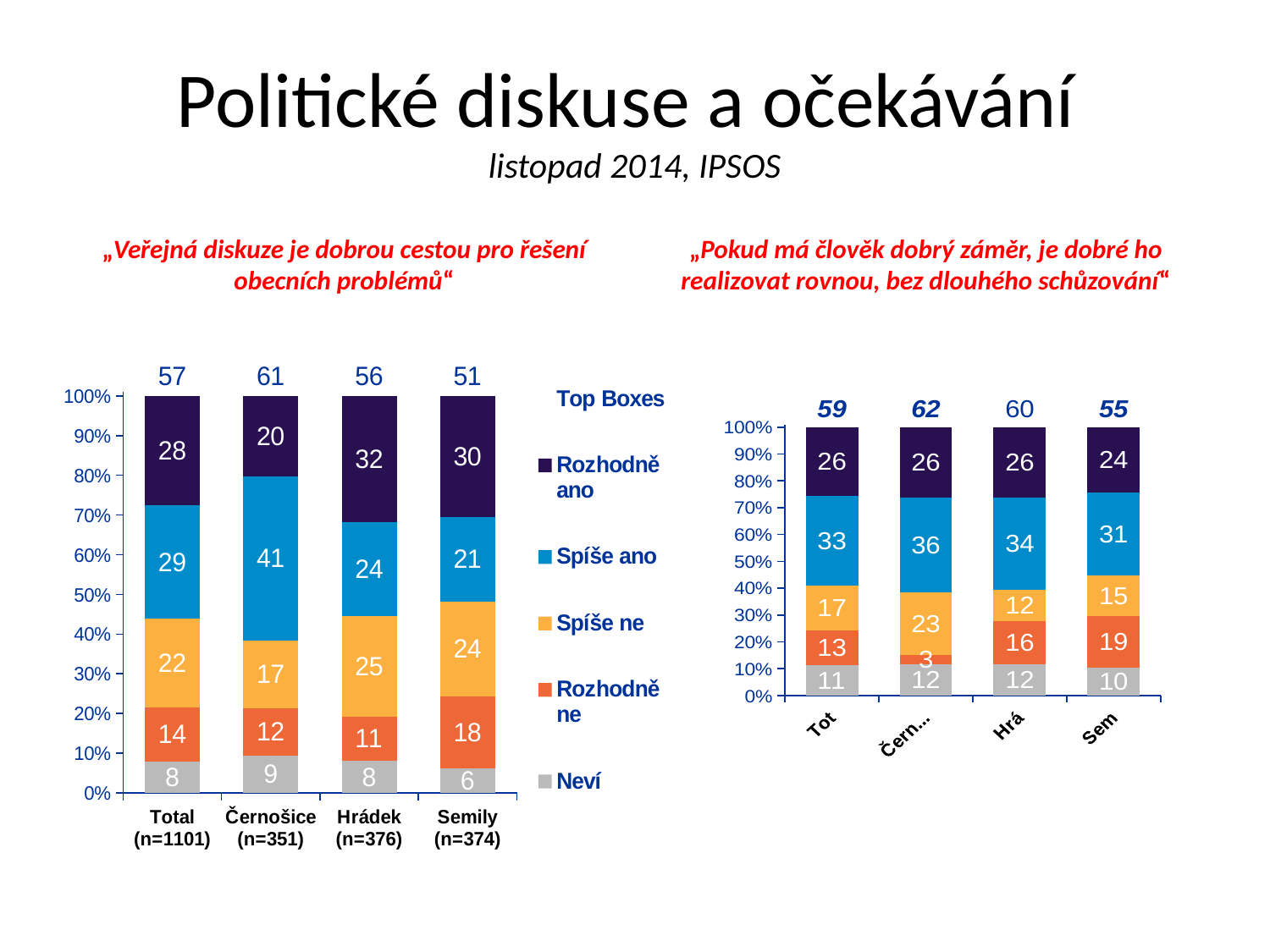
How many categories are shown on the x axis of the right chart ("Pokud má člověk dobrý záměr, je dobré ho realizovat rovnou, bez dlouhého schůzování")? 4 What kind of chart is the left chart ("Veřejná diskuze je dobrou cestou pro řešení obecních problémů")? Stacked bar chart In the left chart ("Veřejná diskuze je dobrou cestou pro řešení obecních problémů"), which category has the highest Top Boxes value? Černošice (n=351) In the right chart ("Pokud má člověk dobrý záměr, je dobré ho realizovat rovnou, bez dlouhého schůzování"), what is the Top Boxes value for the first category (Tot)? 59 In the right chart ("Pokud má člověk dobrý záměr, je dobré ho realizovat rovnou, bez dlouhého schůzování"), is the "Spíše ano" value for the fourth category (Sem) larger or smaller than for the second category (Čern...)? Smaller In the right chart ("Pokud má člověk dobrý záměr, je dobré ho realizovat rovnou, bez dlouhého schůzování"), which category has the lowest "Rozhodně ne" value? Čern... (second category) In the left chart ("Veřejná diskuze je dobrou cestou pro řešení obecních problémů"), how many series does the legend list? 6 In the left chart ("Veřejná diskuze je dobrou cestou pro řešení obecních problémů"), which category has the lowest "Neví" value? Semily (n=374) In the left chart ("Veřejná diskuze je dobrou cestou pro řešení obecních problémů"), what is the difference between the "Rozhodně ano" values for Hrádek (n=376) and Černošice (n=351)? 12 In the left chart ("Veřejná diskuze je dobrou cestou pro řešení obecních problémů"), what is the value of "Rozhodně ne" for Semily (n=374)? 18 In the right chart ("Pokud má člověk dobrý záměr, je dobré ho realizovat rovnou, bez dlouhého schůzování"), what is the value of "Spíše ne" for the second category (Čern...)? 23 In the left chart ("Veřejná diskuze je dobrou cestou pro řešení obecních problémů"), what is the value of "Spíše ano" for Černošice (n=351)? 41